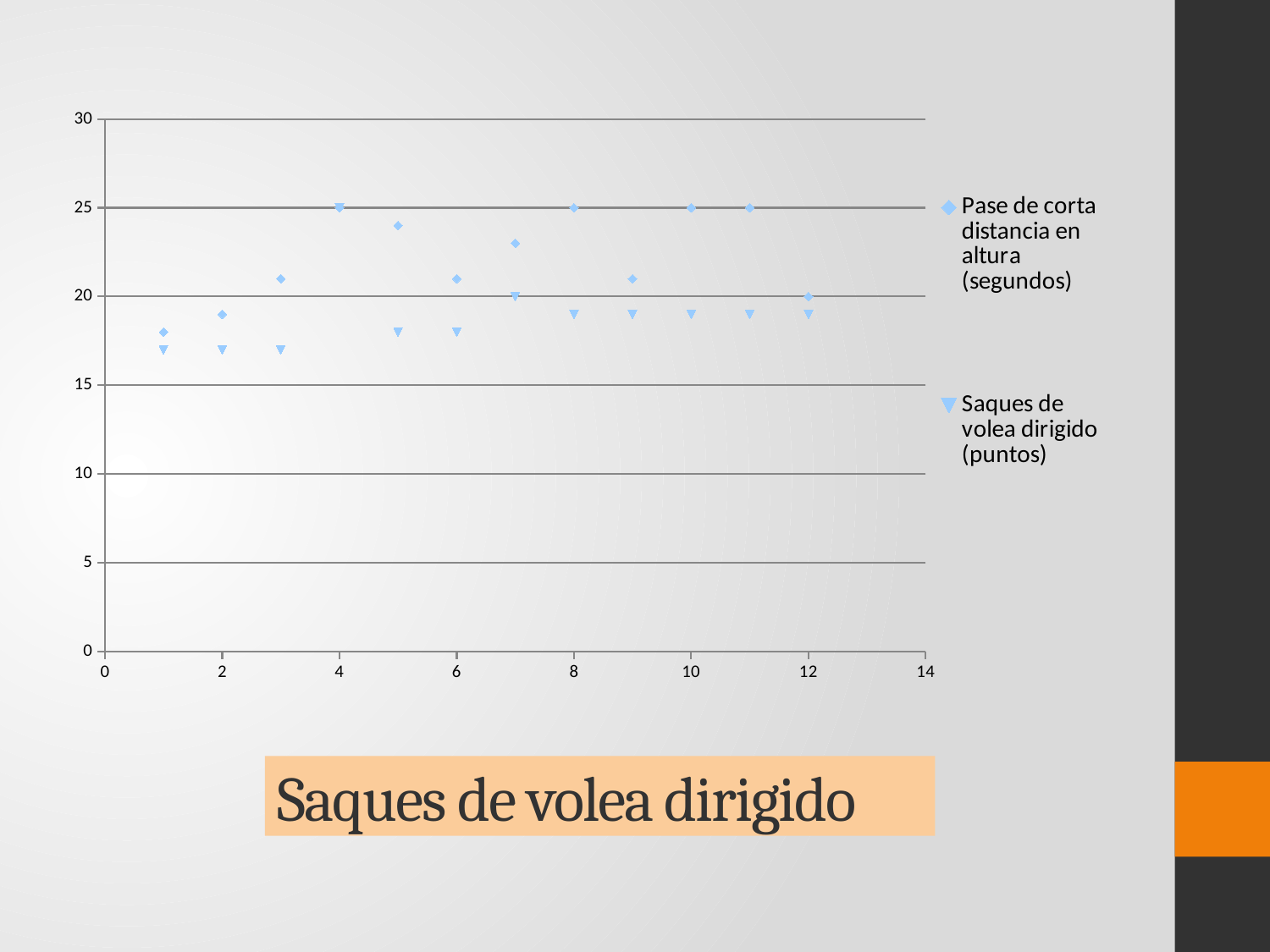
What is the value of 'Pase de corta distancia en altura (segundos)' at x = 4? 25 At x = 8, which series has the higher value? Pase de corta distancia en altura (segundos) What title is shown below the chart? Saques de volea dirigido What marker shape is used for the series 'Saques de volea dirigido (puntos)'? triangle How many data points are plotted for the series 'Pase de corta distancia en altura (segundos)'? 12 How many series does the legend list? 2 What is the value of 'Saques de volea dirigido (puntos)' at x = 7? 20 Is the value for 'Saques de volea dirigido (puntos)' at x = 1 greater or less than 20? less What kind of chart is shown on the slide? scatter chart Is the value for 'Saques de volea dirigido (puntos)' at x = 12 higher or lower than at x = 1? higher Is the value for 'Pase de corta distancia en altura (segundos)' at x = 5 greater or less than 20? greater What is the value of 'Pase de corta distancia en altura (segundos)' at x = 12? 20